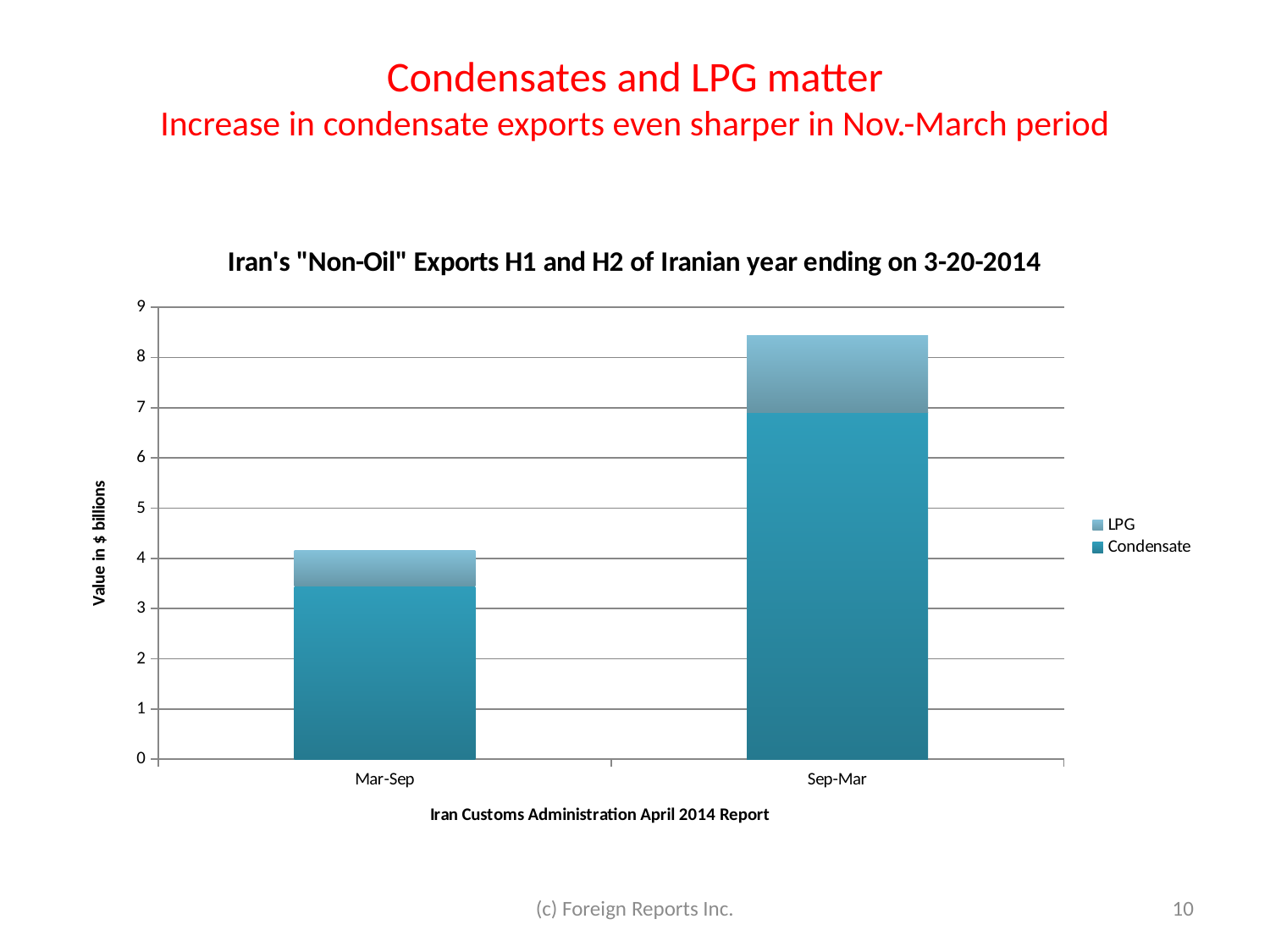
What is the label on the vertical axis of the chart? Value in $ billions Do total exports rise or fall from Mar-Sep to Sep-Mar? rise How many categories are shown on the x axis? 2 Is the Condensate value for Mar-Sep greater or less than 3? greater How many series does the legend list? 2 Which period has the larger Condensate value, Mar-Sep or Sep-Mar? Sep-Mar Which period has the highest total non-oil exports? Sep-Mar Is the Condensate value for Sep-Mar greater or less than 6? greater Is the total value of the Sep-Mar bar greater or less than 8? greater Which period has the lowest total non-oil exports? Mar-Sep What kind of chart is shown on the slide? Stacked bar chart